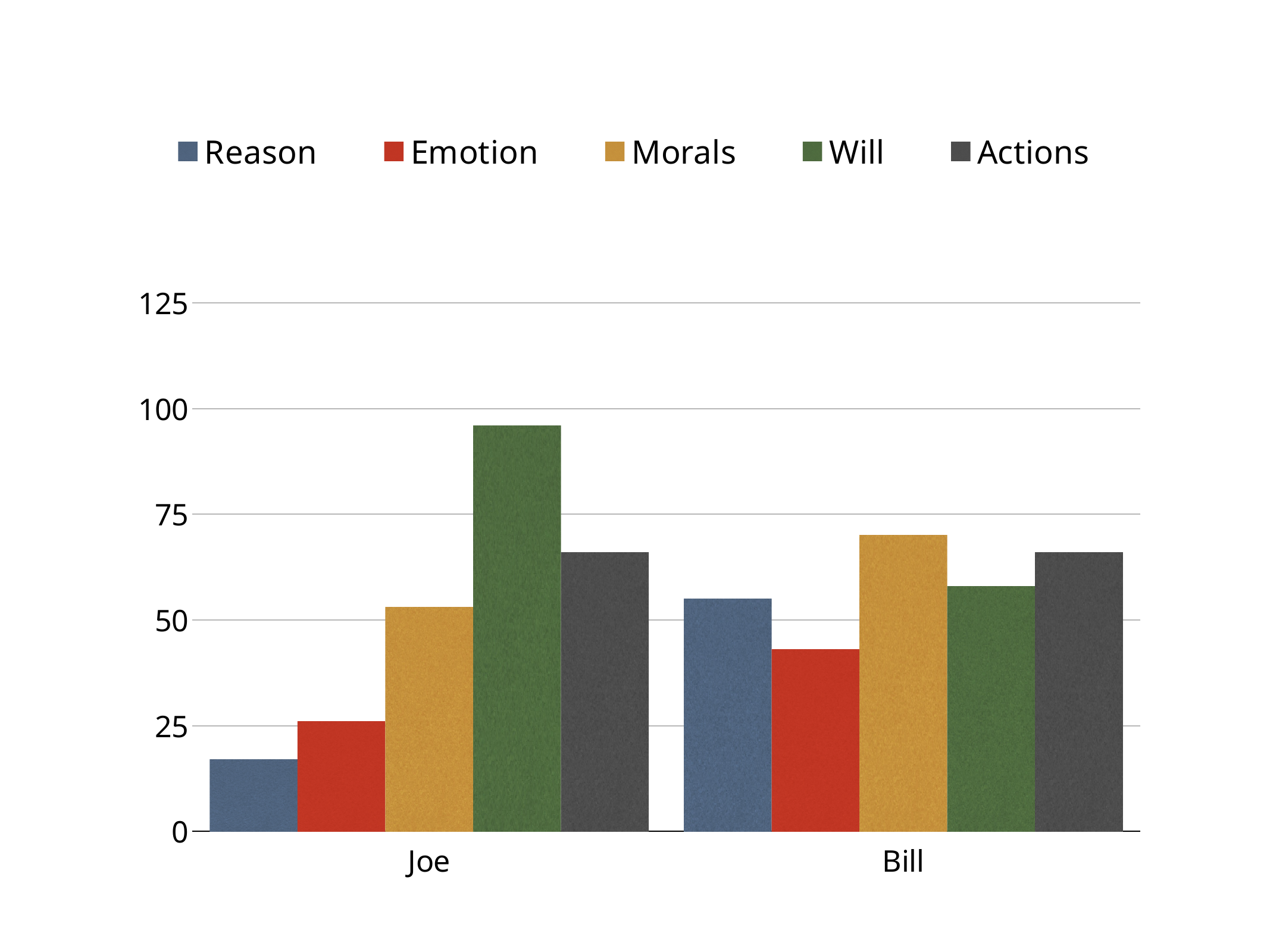
Is the value of Will for Joe greater or less than 75? greater How many series does the legend list? 5 Which series has the highest value for Bill? Morals Which series has the lowest value for Bill? Emotion Is the value of Reason for Joe greater or less than 25? less Which is larger, the Reason value for Joe or the Reason value for Bill? Bill Which series has the lowest value for Joe? Reason Is the value of Emotion for Bill greater or less than 50? less Which colour represents the Morals series in the legend? orange How many categories are shown on the x axis? 2 What kind of chart is shown on the slide? bar chart Which series has the highest value for Joe? Will